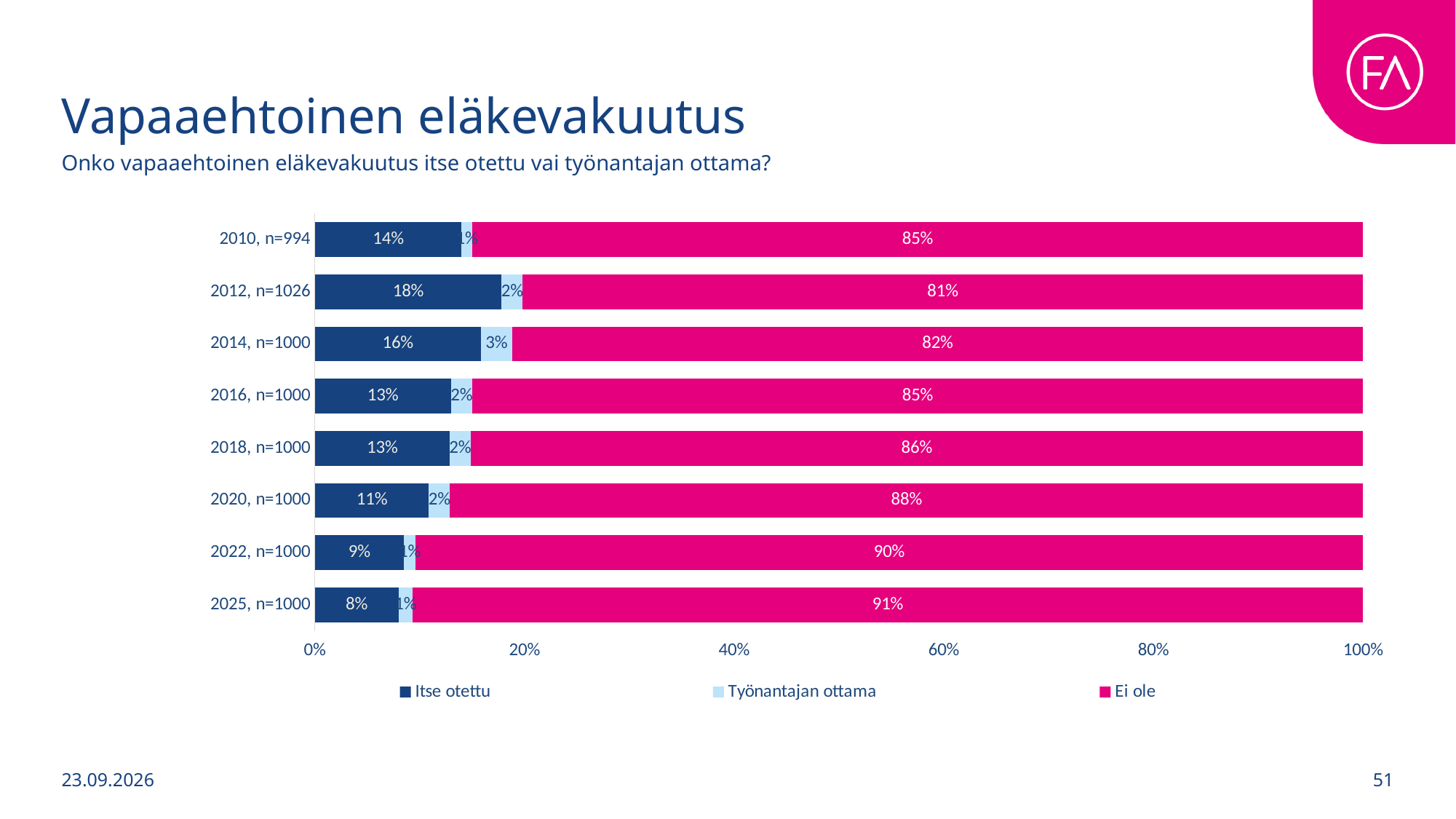
Which category has the lowest value for Ei ole? 2012, n=1026 Which is larger, the Itse otettu value for 2014, n=1000 or for 2016, n=1000? 2014, n=1000 What kind of chart is shown on the slide? Stacked bar chart Which category has the highest value for Itse otettu? 2012, n=1026 How many series does the legend list? 3 From 2014, n=1000 to 2025, n=1000, does the Itse otettu value rise or fall? Fall What is the value for Ei ole in 2025, n=1000? 91% What is the value for Itse otettu in 2012, n=1026? 18% What is the value for Työnantajan ottama in 2014, n=1000? 3% What is the difference between the Ei ole value in 2025, n=1000 and in 2010, n=994? 6 percentage points How many categories are shown on the chart? 8 Which category has the lowest value for Itse otettu? 2025, n=1000